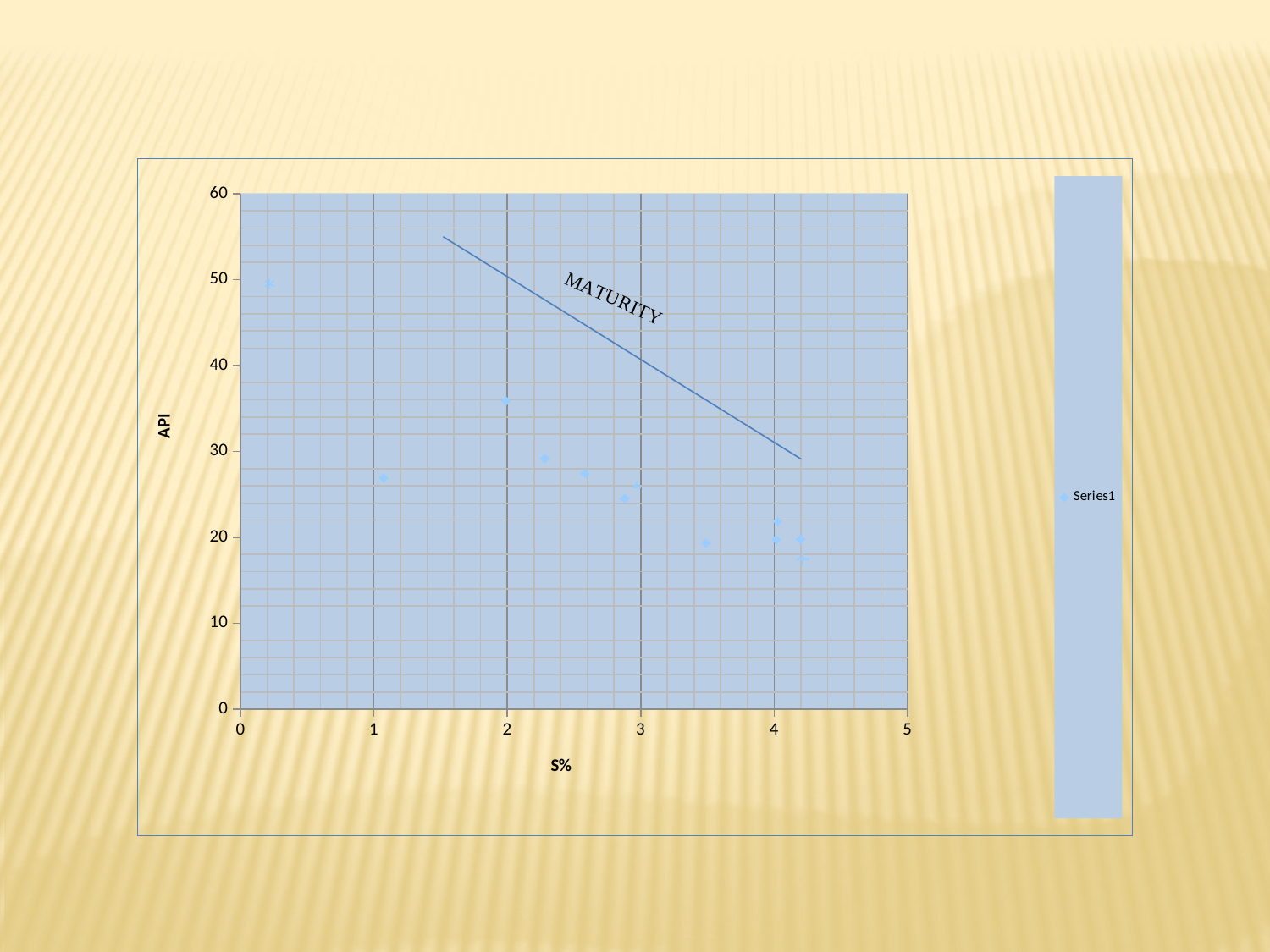
Is the API value for the point at about S% = 2.3 greater or less than 40? less Is the API value for the point at S% = 2 greater or less than 30? greater Is the API value for the point at about S% = 0.2 greater or less than 40? greater Do the API values generally rise or fall as S% increases? fall What kind of chart is shown on the slide? scatter chart What is the name of the series shown in the legend? Series1 What is the label of the vertical axis? API What is the highest value shown on the API axis? 60 What is the label of the horizontal axis? S% Which point has the highest API value: the one at about S% = 0.2 or the one at S% = 2? the one at about S% = 0.2 How many series does the legend list? 1